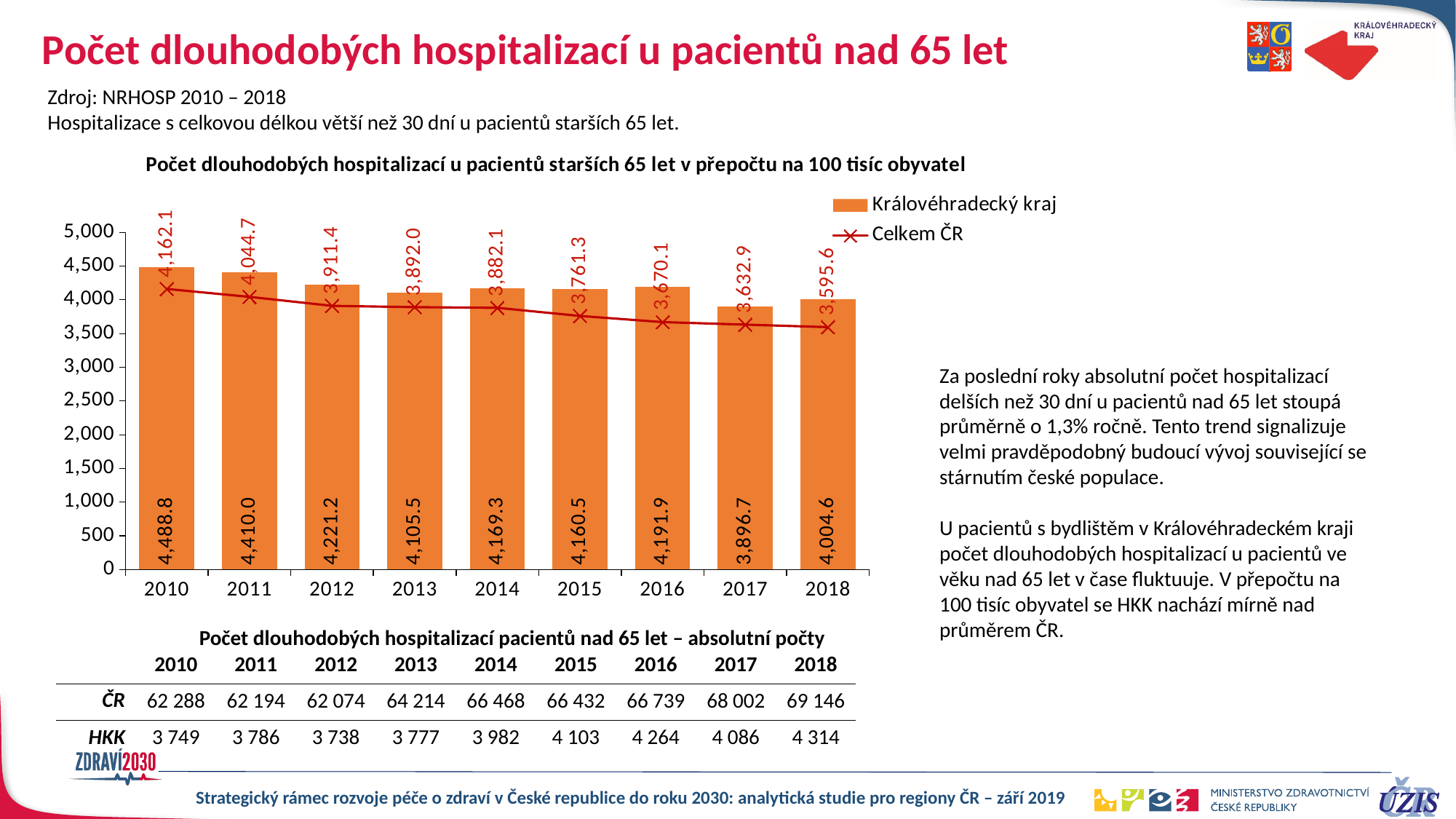
Which is larger in 2013: the value for Královéhradecký kraj or the value for Celkem ČR? Královéhradecký kraj What is the value for Celkem ČR in 2018? 3,595.6 What is the difference between the Královéhradecký kraj value and the Celkem ČR value in 2016? 521.8 How many series does the legend list? 2 Which year has the lowest value for Celkem ČR? 2018 What kind of chart is used for the Královéhradecký kraj series? Bar chart What is the value for Královéhradecký kraj in 2017? 3,896.7 How many years are shown on the x axis? 9 Does the Celkem ČR series rise or fall from 2010 to 2018? Fall What is the value for Královéhradecký kraj in 2010? 4,488.8 Which year has the lowest value for Královéhradecký kraj? 2017 Which year has the highest value for Královéhradecký kraj? 2010